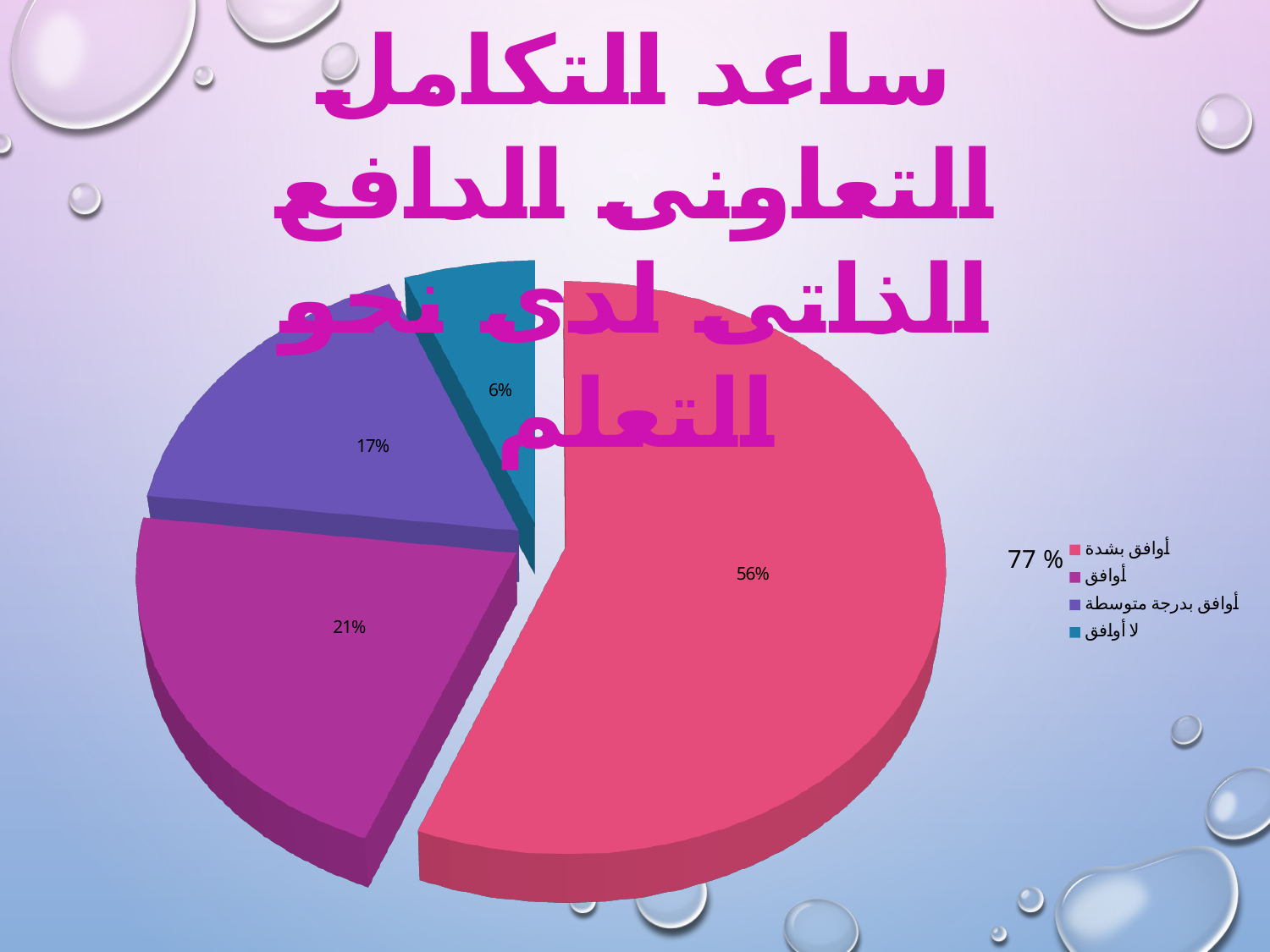
What is the difference in percentage points between the أوافق بشدة slice and the أوافق slice? 35 Which category has the smallest slice of the pie? لا أوافق What percentage of the pie is the slice for أوافق? 21% How many slices does the pie chart have? 4 Which slice is larger, أوافق or أوافق بدرجة متوسطة? أوافق What kind of chart is shown on the slide? pie chart Which category has the largest slice of the pie? أوافق بشدة What percentage of the pie is the slice for أوافق بشدة? 56% What percentage of the pie is the slice for لا أوافق? 6% What percentage of the pie is the slice for أوافق بدرجة متوسطة? 17% How many entries does the legend list? 4 What colour is the slice for لا أوافق? teal blue